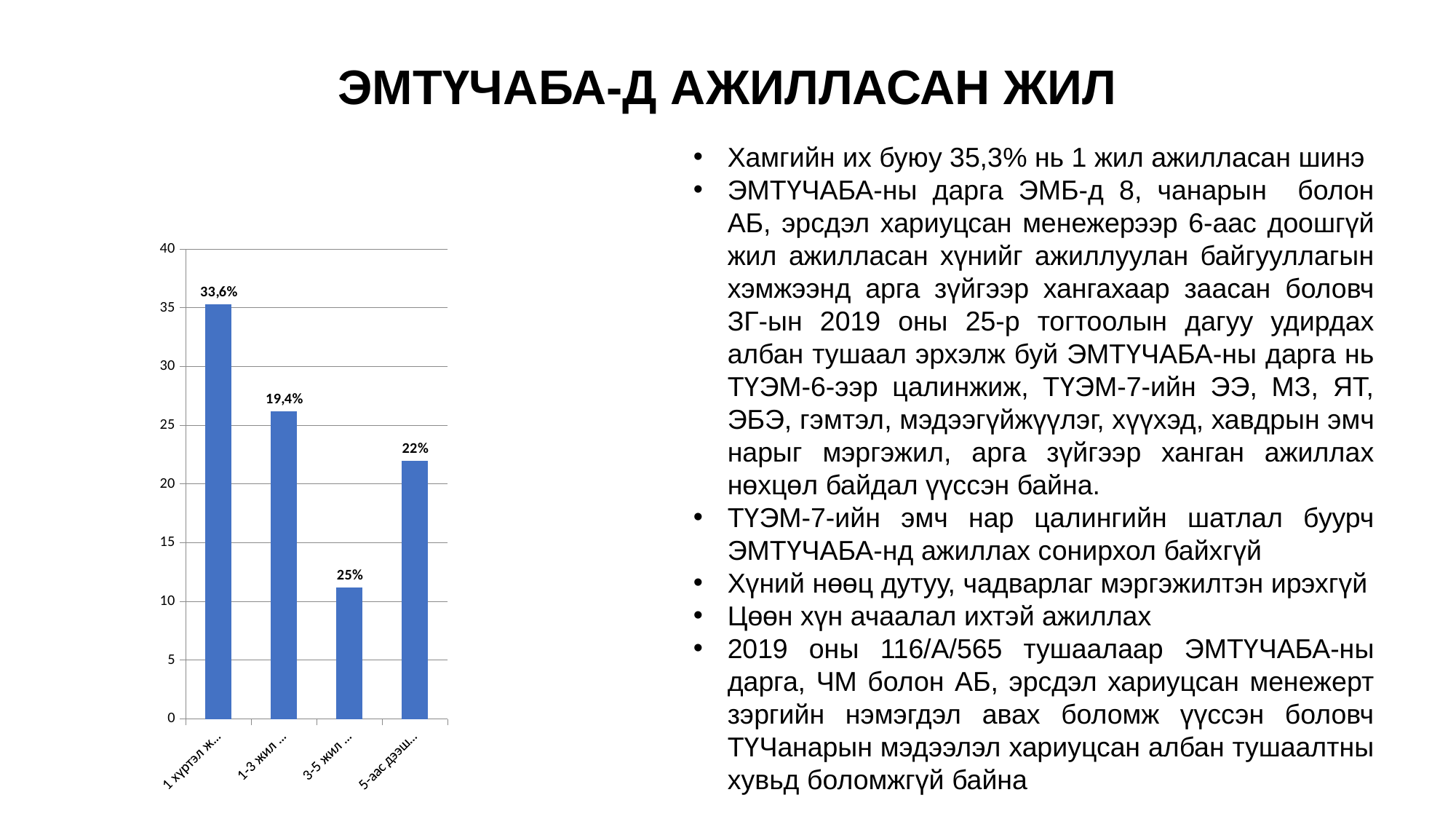
What kind of chart is shown on the slide? bar chart What is the difference between the data labels of the first bar (33,6%) and the second bar (19,4%)? 14,2% What is the data label on the third bar ("3-5 жил ...")? 25% What is the data label on the first bar ("1 хүртэл ж...")? 33,6% What is the data label on the second bar ("1-3 жил ...")? 19,4% What is the data label on the fourth bar ("5-аас дээш...")? 22% Which bar is taller, the first bar ("1 хүртэл ж...") or the fourth bar ("5-аас дээш...")? the first bar (1 хүртэл ж...) Is the value of the third bar ("3-5 жил ...") greater or less than 15 on the axis? less Is the value of the first bar ("1 хүртэл ж...") greater or less than 30 on the axis? greater How many bars (categories) does the chart have? 4 What is the highest value shown on the vertical axis of the chart? 40 Which category has the tallest bar in the chart? 1 хүртэл ж... (the first bar)